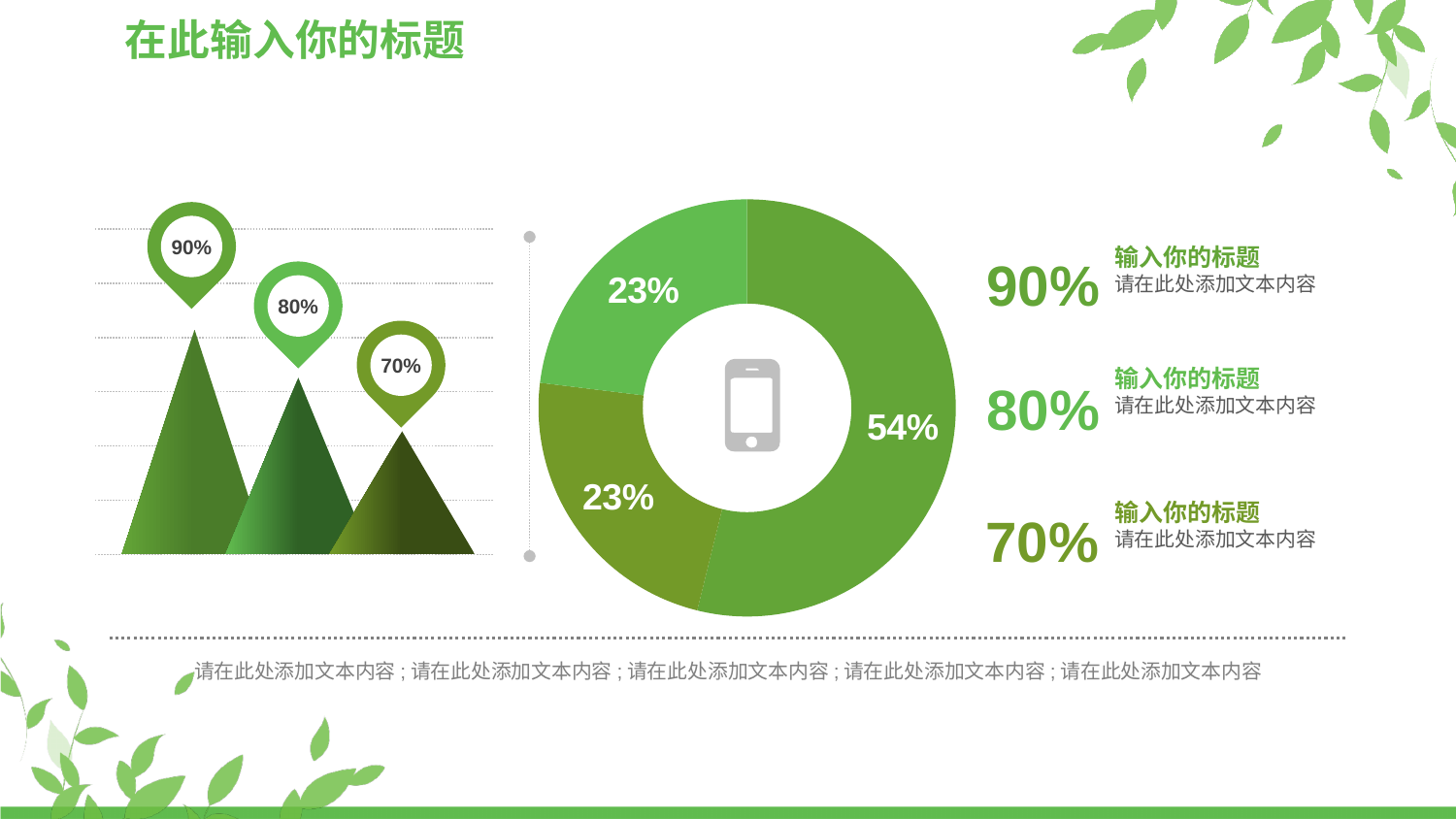
In the donut chart in the centre of the slide, what share of the whole does the right-hand slice represent? 54% In the donut chart in the centre of the slide, what is the difference between the largest slice and the lower-left slice? 31 percentage points In the donut chart in the centre of the slide, how many slices are there? 3 In the triangle chart on the left of the slide, do the values rise or fall from left to right? fall What kind of chart is the chart in the centre of the slide? Pie (donut) chart In the triangle chart on the left of the slide, what value is labelled on the leftmost triangle? 90% In the triangle chart on the left of the slide, what value is labelled on the rightmost triangle? 70% In the donut chart in the centre of the slide, what is the value of the largest slice? 54% In the triangle chart on the left of the slide, what is the difference between the leftmost and rightmost values? 20 percentage points In the donut chart in the centre of the slide, is the largest slice greater or less than 50%? greater In the donut chart in the centre of the slide, what value is shown on the upper-left slice? 23% In the triangle chart on the left of the slide, how many triangles (data points) are shown? 3